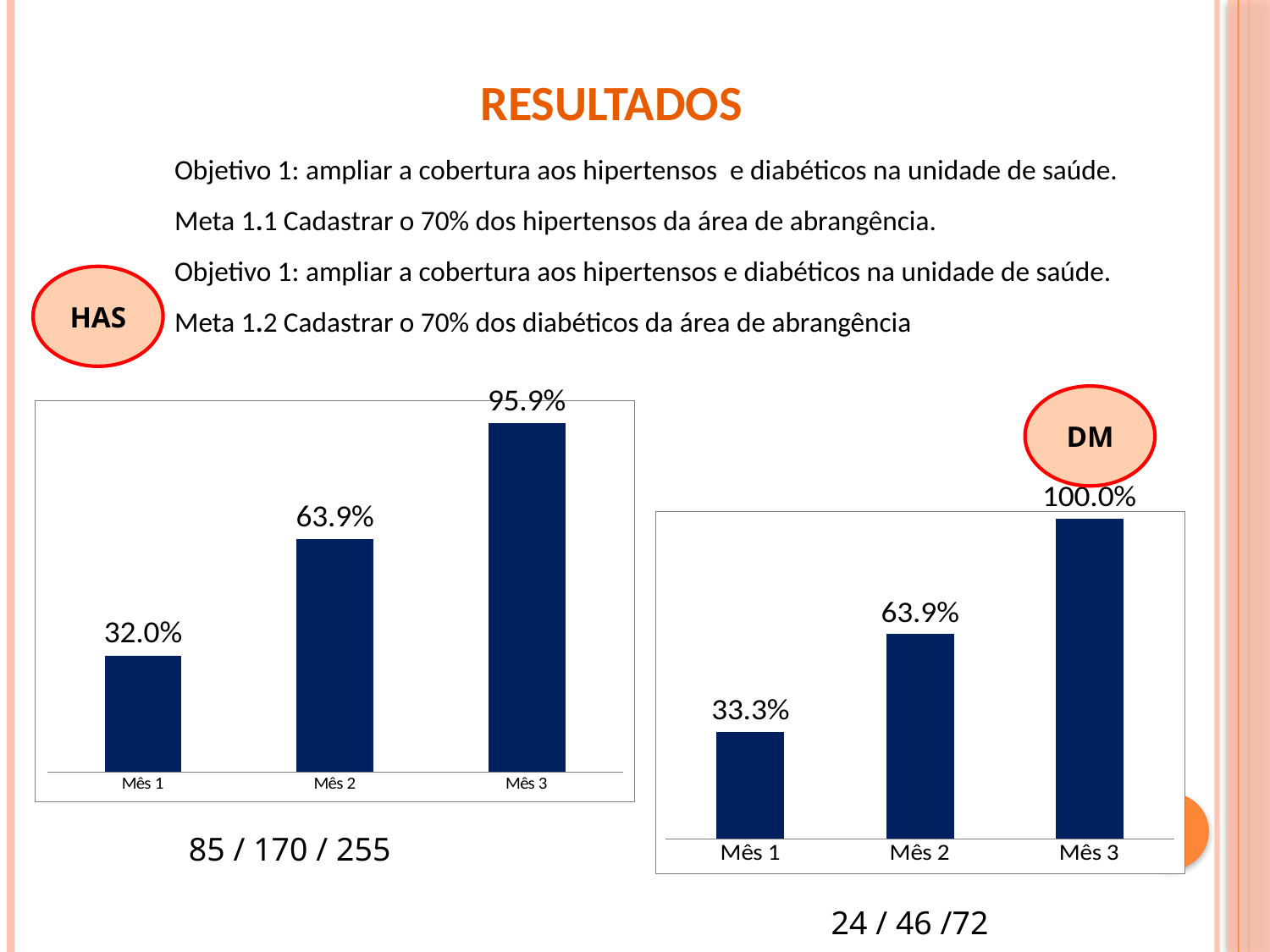
In the right chart (DM), which month has the lowest value? Mês 1 In the left chart (HAS), what is the difference between the values for Mês 3 and Mês 2? 32.0% In the right chart (DM), what is the difference between the values for Mês 2 and Mês 1? 30.6% In the right chart (DM), do the values rise or fall from Mês 1 to Mês 3? Rise What type of chart is the right chart (DM)? Bar chart In the left chart (HAS), what is the value for Mês 3? 95.9% In the left chart (HAS), what is the value for Mês 1? 32.0% Which is larger: the Mês 1 value in the left chart (HAS) or the Mês 1 value in the right chart (DM)? Right chart (DM), 33.3% In the right chart (DM), what is the value for Mês 3? 100.0% In the left chart (HAS), which month has the highest value? Mês 3 In the right chart (DM), what is the value for Mês 1? 33.3% How many bars does the left chart (HAS) have? 3